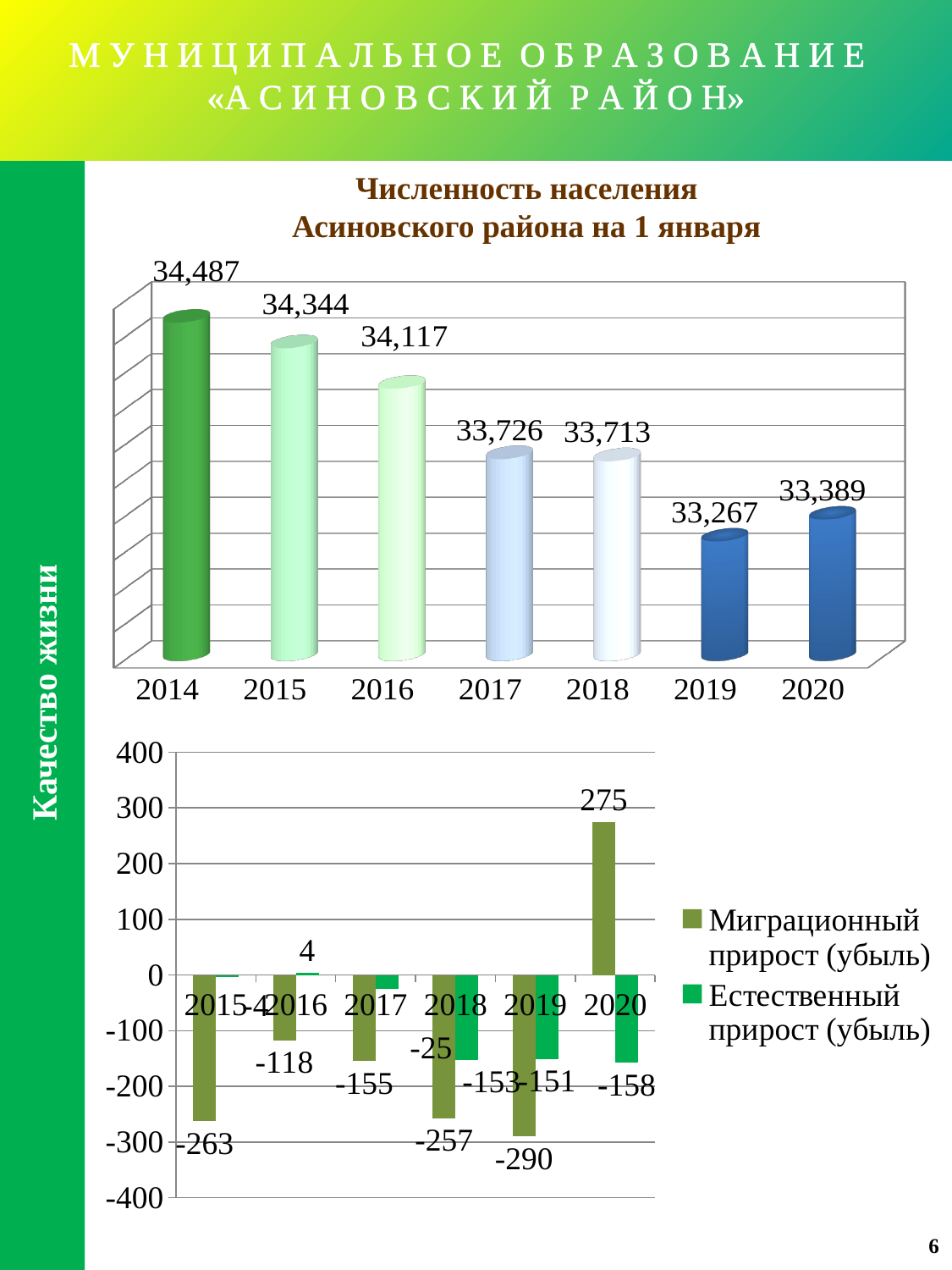
In the chart 'Численность населения Асиновского района на 1 января', what is the difference between the 2014 and 2020 values? 1,098 In the bottom chart, what is the value of 'Естественный прирост (убыль)' for 2016? 4 In the chart 'Численность населения Асиновского района на 1 января', does the population generally rise or fall from 2014 to 2019? fall In the bottom chart, which year has the lowest value of 'Миграционный прирост (убыль)'? 2019 In the chart 'Численность населения Асиновского района на 1 января', which year has the highest population? 2014 In the chart 'Численность населения Асиновского района на 1 января', how many years are shown? 7 In the bottom chart, what is the value of 'Миграционный прирост (убыль)' for 2020? 275 In the bottom chart, which is larger: 'Миграционный прирост (убыль)' for 2016 or for 2019? 2016 In the chart 'Численность населения Асиновского района на 1 января', what is the population value for 2014? 34,487 In the chart 'Численность населения Асиновского района на 1 января', what is the population value for 2020? 33,389 In the bottom chart, how many series does the legend list? 2 In the chart 'Численность населения Асиновского района на 1 января', which year has the lowest population? 2019